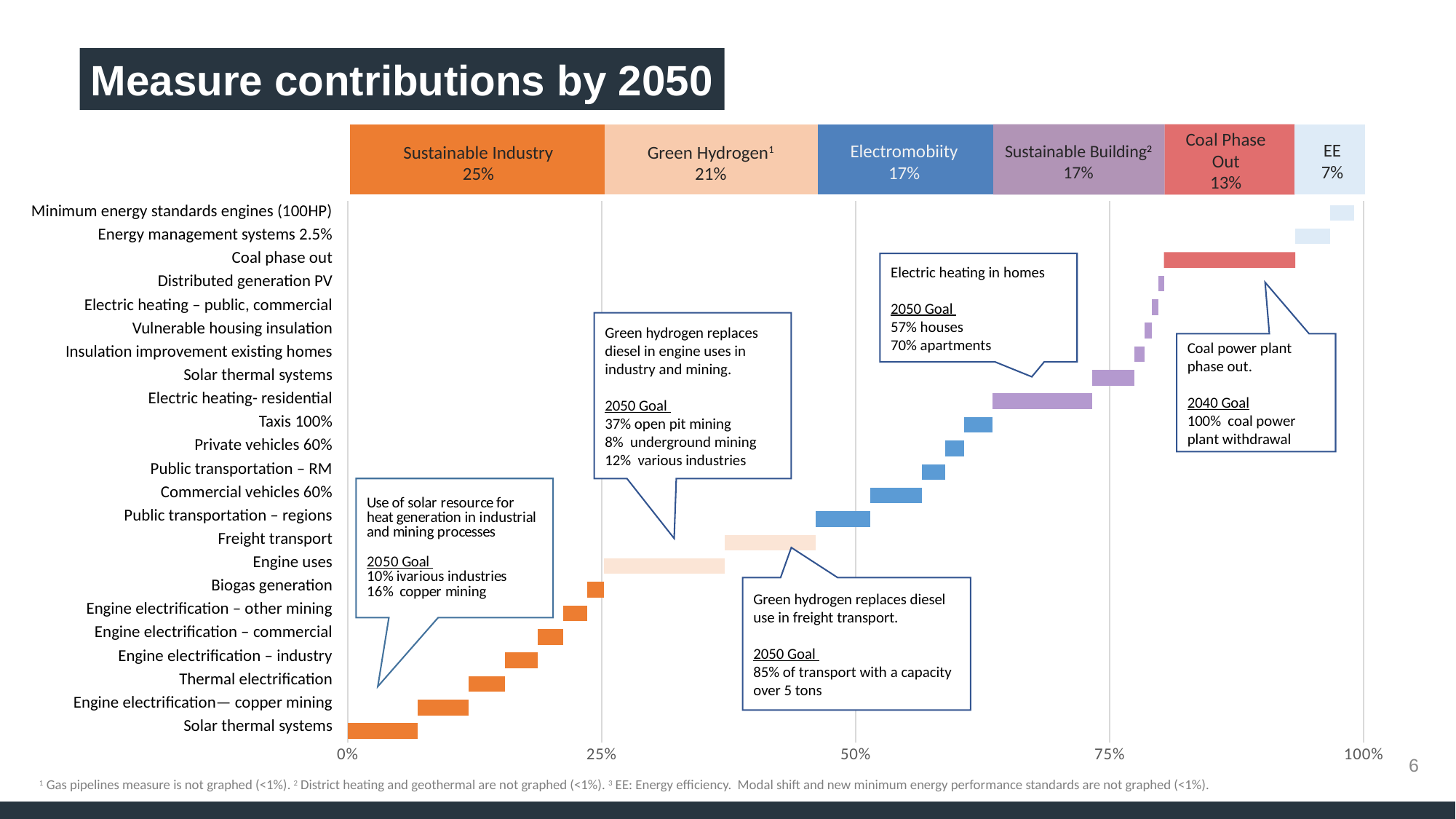
What percentage contribution is shown for Sustainable Industry in the header band? 25% Which contribution is larger, Coal Phase Out or EE? Coal Phase Out Is the right end of the Coal phase out bar greater or less than 75%? greater What type of chart is shown on the slide? Bar chart (waterfall) How many measure groups are shown in the coloured header band above the chart? 6 What percentage contribution is shown for Green Hydrogen? 21% Which measure group has the largest contribution by 2050? Sustainable Industry What percentage contribution is shown for Coal Phase Out? 13% How many percentage points larger is the Sustainable Industry contribution than the Green Hydrogen contribution? 4 What percentage contribution is shown for EE? 7% Which measure group has the smallest contribution by 2050? EE How many individual measures are listed on the vertical axis? 23